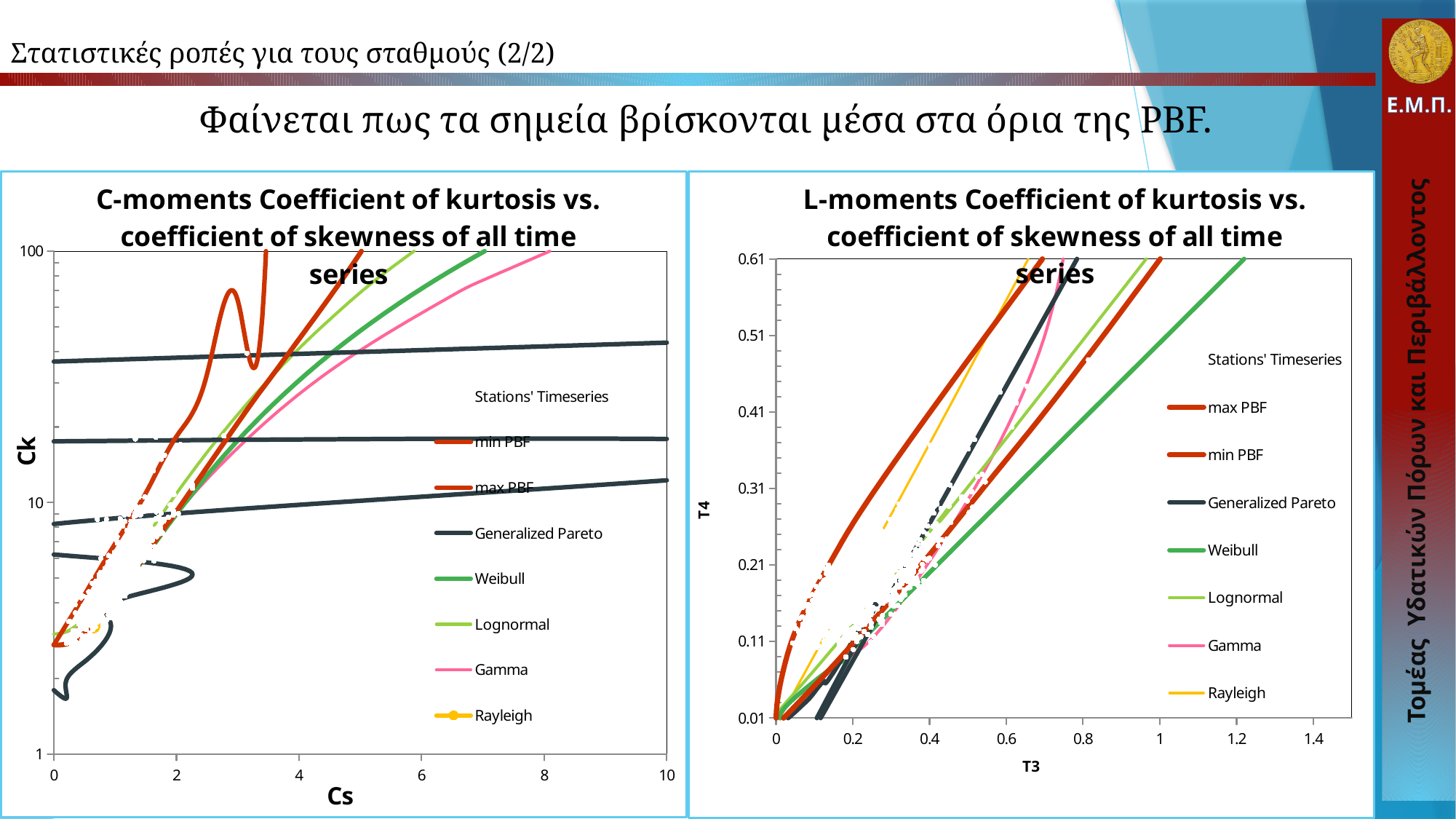
What is the label of the x axis of the right chart (L-moments)? T3 What kind of chart is the right chart titled 'L-moments Coefficient of kurtosis vs. coefficient of skewness of all time series'? Scatter/line chart In the left chart (C-moments), does the Gamma curve rise or fall as Cs increases? Rises What kind of chart is the left chart titled 'C-moments Coefficient of kurtosis vs. coefficient of skewness of all time series'? Scatter/line chart How many series does the legend of the right chart (L-moments) list? 8 What is the label of the y axis of the left chart (C-moments)? Ck How many series does the legend of the left chart (C-moments) list? 8 In the right chart (L-moments), does the max PBF curve rise or fall as T3 increases? Rises